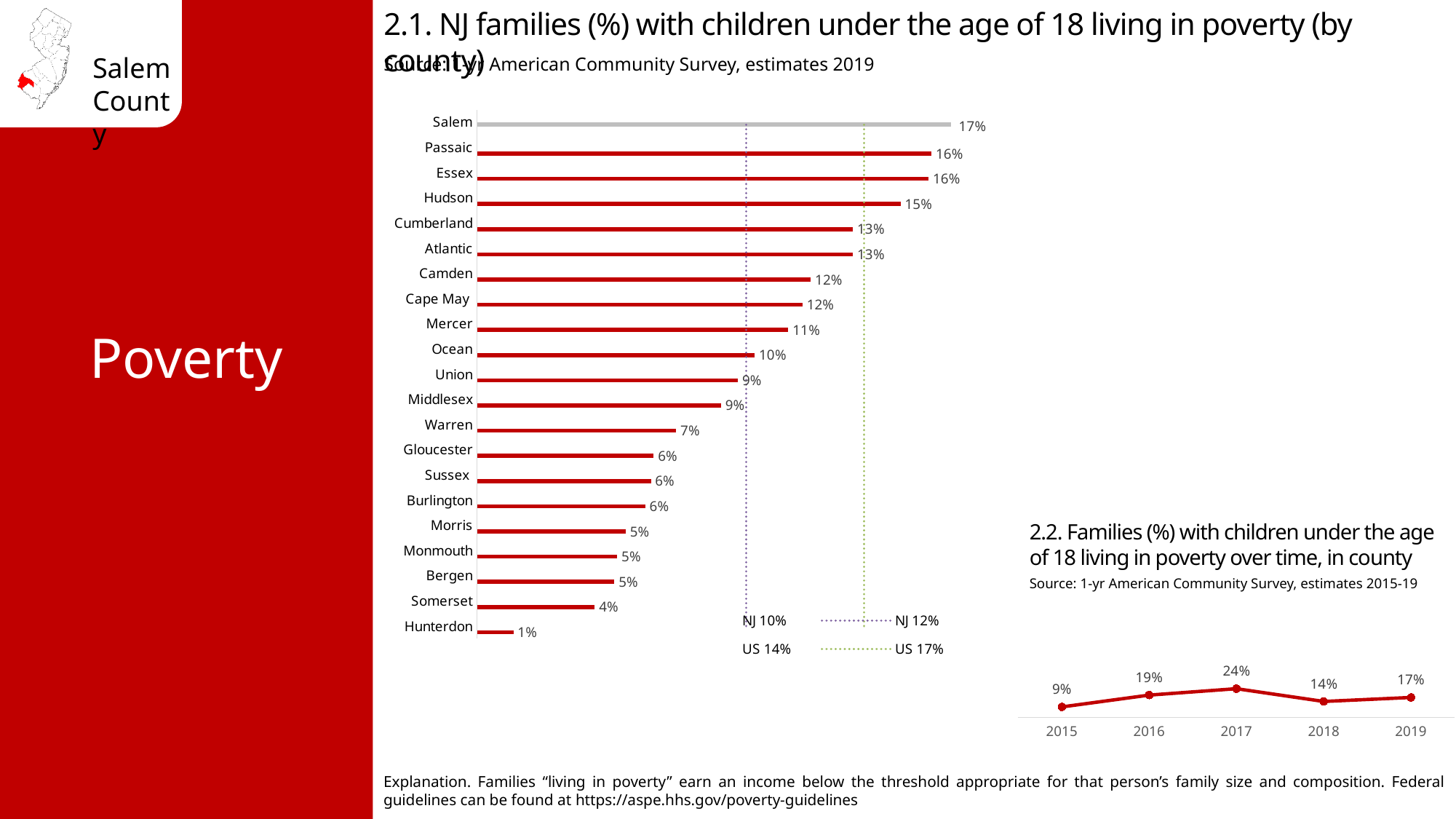
In chart 2.2 (poverty over time, in county), which year has the lowest value? 2015 In chart 2.1 (by county), which county has the highest value? Salem In chart 2.1 (by county), what is the value for Hudson? 15% In chart 2.1 (by county), how many counties are plotted? 21 What kind of chart is chart 2.2 (poverty over time, in county)? Line chart In chart 2.1 (by county), which is larger, the value for Camden or the value for Warren? Camden In chart 2.2 (poverty over time, in county), what is the difference between 2017 and 2018? 10% In chart 2.2 (poverty over time, in county), what is the value for 2017? 24% In chart 2.1 (by county), what is the difference between Salem and Hunterdon? 16% In chart 2.1 (by county), which county has the lowest value? Hunterdon What kind of chart is chart 2.1 (by county)? Bar chart In chart 2.1 (NJ families with children under 18 living in poverty by county), what is the value for Salem? 17%